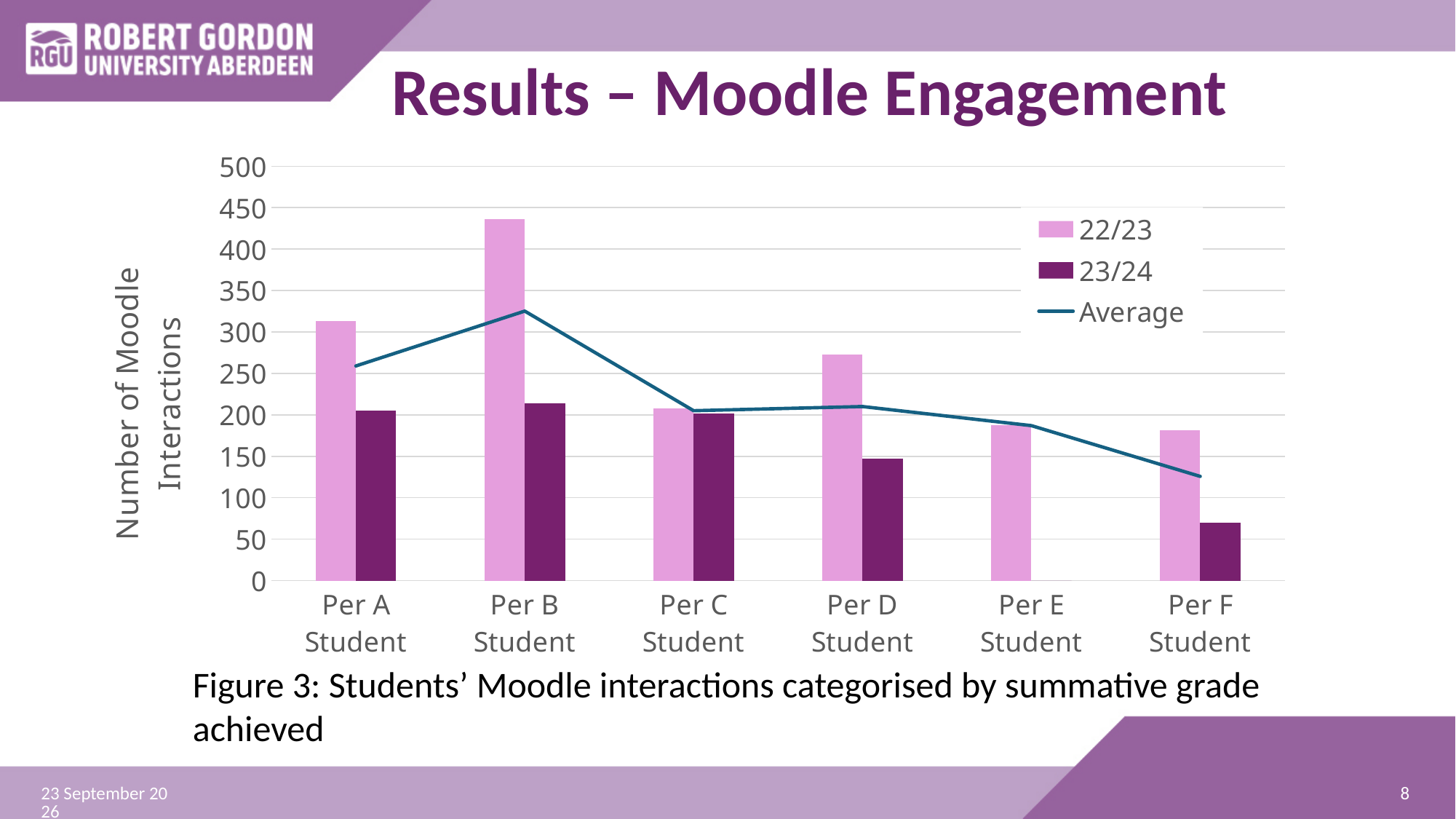
Which category has the highest 22/23 value? Per B Student What is the title of the y axis? Number of Moodle Interactions For Per A Student, which is larger: the 22/23 value or the 23/24 value? 22/23 How many categories are shown on the x axis? 6 Does the Average line rise or fall from Per D Student to Per F Student? fall What kind of chart is shown on the slide? combination bar and line chart Is the 22/23 value for Per B Student greater or less than 400? greater How many series does the legend list? 3 Is the 23/24 value for Per D Student greater or less than 200? less Is the 23/24 value for Per F Student greater or less than 100? less At which category does the Average line reach its highest point? Per B Student